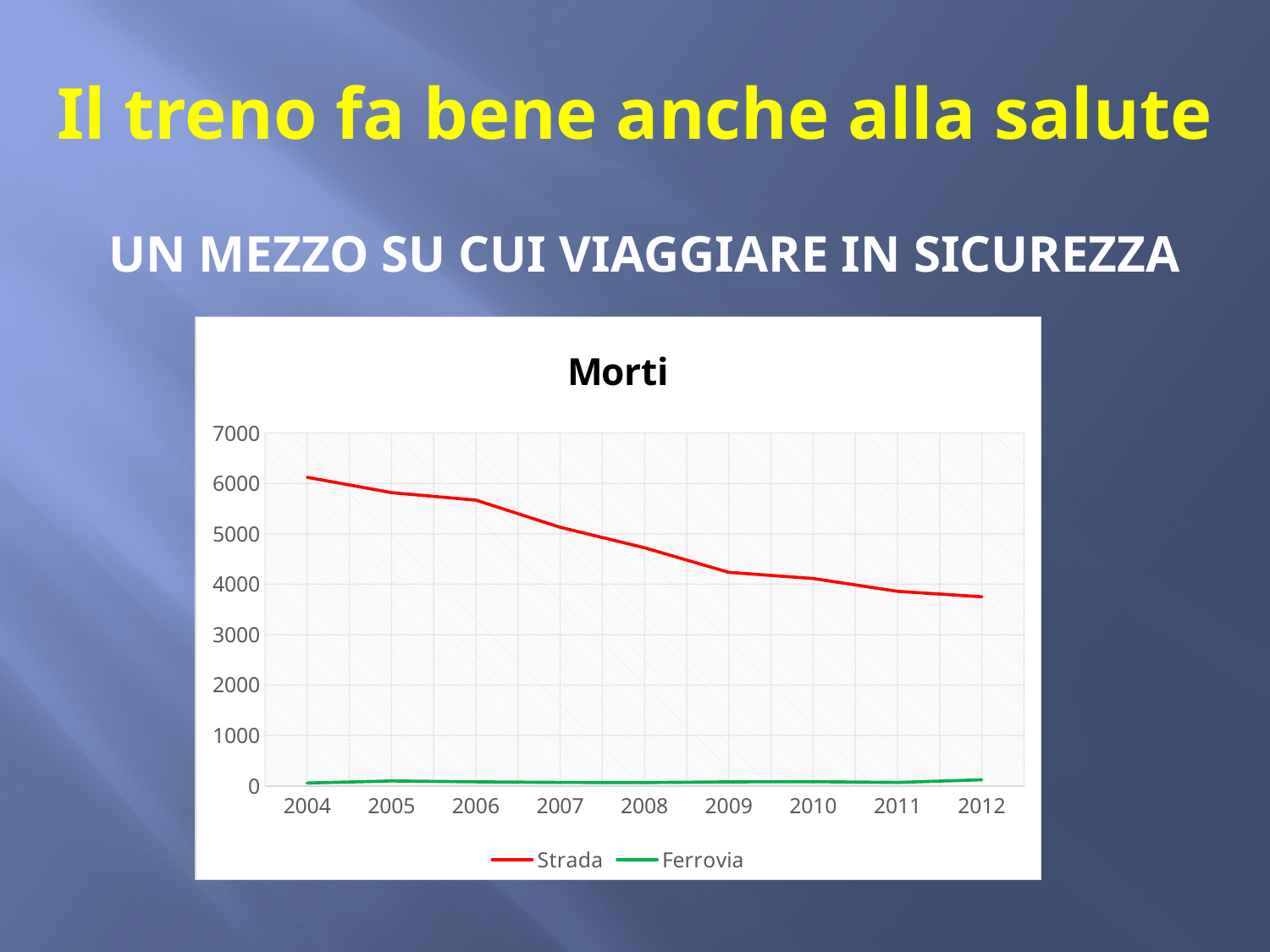
Is the Strada value for 2012 greater or less than 4000? less How many years are plotted along the x axis? 9 In which year is the Strada value lowest? 2012 Is the Ferrovia value for 2008 greater or less than 1000? less Which series has the larger value in 2008, Strada or Ferrovia? Strada What kind of chart is shown on the slide? line chart Is the Strada value for 2004 greater or less than 5000? greater Does the Strada series rise or fall from 2004 to 2012? fall What is the title of the chart? Morti In which year is the Strada value highest? 2004 How many series does the legend list? 2 Which series is drawn in red? Strada